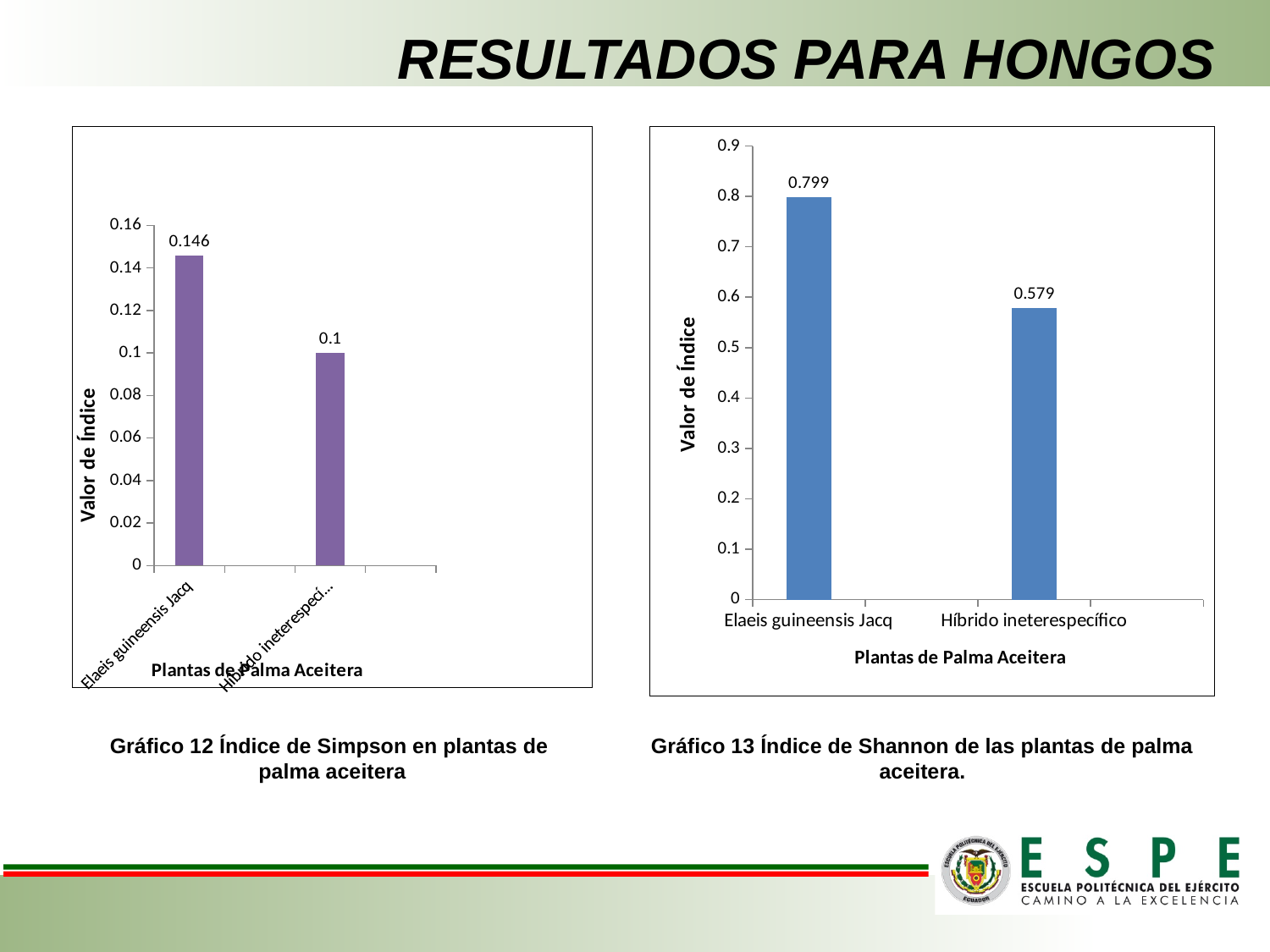
In the right chart (Gráfico 13, Índice de Shannon), what is the value for Elaeis guineensis Jacq? 0.799 In the left chart (Gráfico 12, Índice de Simpson), what is the value for the Híbrido category? 0.1 What is the y-axis title of the right chart (Gráfico 13, Índice de Shannon)? Valor de Índice In the right chart (Gráfico 13, Índice de Shannon), what is the difference between the values for Elaeis guineensis Jacq and Híbrido ineterespecífico? 0.22 How many bars are plotted in the left chart (Gráfico 12, Índice de Simpson)? 2 In the left chart (Gráfico 12, Índice de Simpson), what is the difference between the values for Elaeis guineensis Jacq and the Híbrido category? 0.046 In the left chart (Gráfico 12, Índice de Simpson), what is the value for Elaeis guineensis Jacq? 0.146 In the left chart (Gráfico 12, Índice de Simpson), which category has the lowest value? Híbrido In the right chart (Gráfico 13, Índice de Shannon), which category has the highest value? Elaeis guineensis Jacq In the right chart (Gráfico 13, Índice de Shannon), is the value for Híbrido ineterespecífico greater or less than 0.6? less What kind of chart is the right chart (Gráfico 13, Índice de Shannon)? bar chart In the right chart (Gráfico 13, Índice de Shannon), what is the value for Híbrido ineterespecífico? 0.579